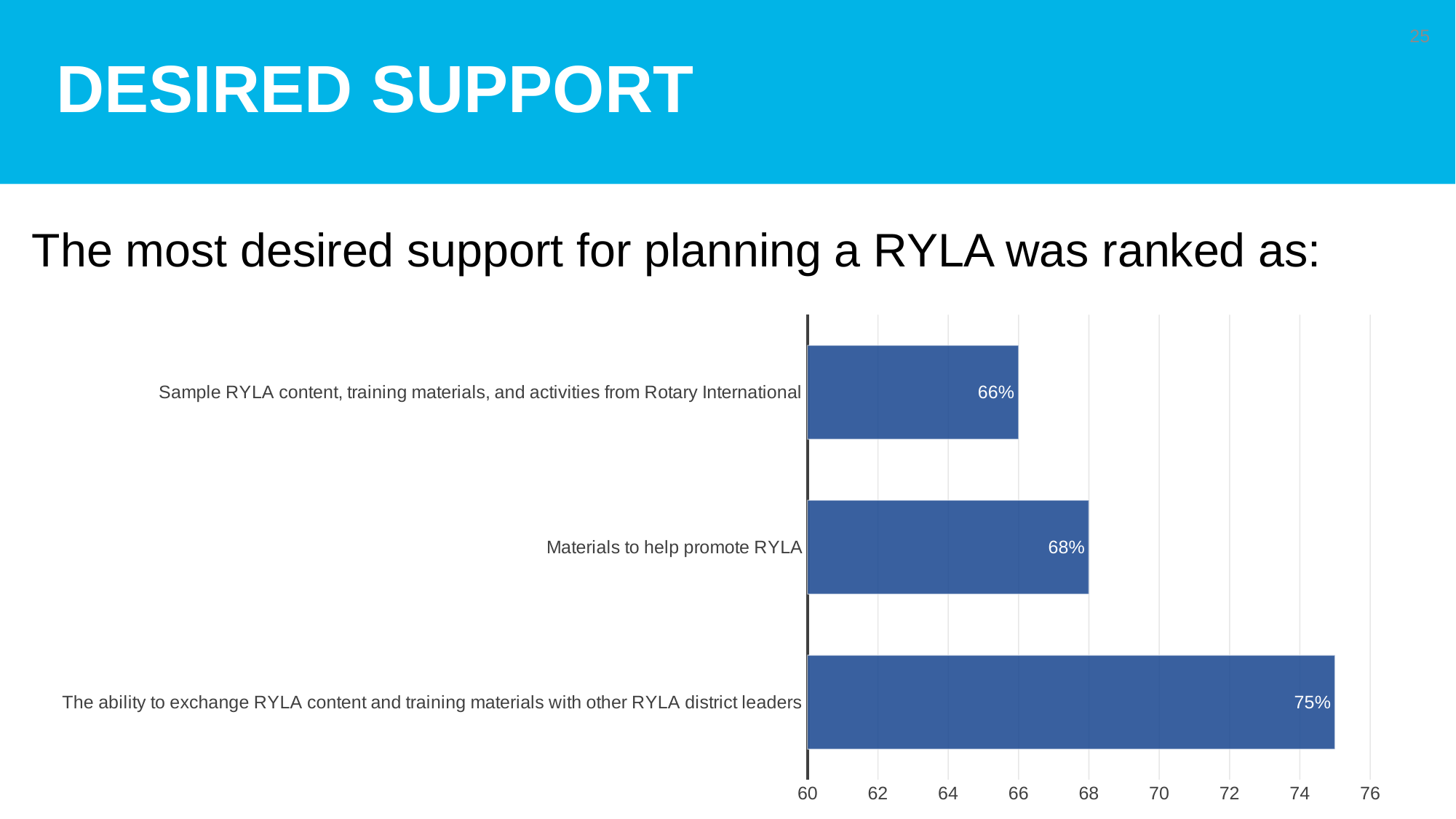
Is the value for 'Materials to help promote RYLA' greater or less than 70? less What kind of chart is shown on the slide? Bar chart How many categories of desired support are shown in the chart? 3 What is the difference between the percentage for exchanging RYLA content with other district leaders and the percentage for materials to help promote RYLA? 7% What percentage is shown for the ability to exchange RYLA content and training materials with other RYLA district leaders? 75% What is the maximum value shown on the horizontal axis of the chart? 76 What is the value for 'Materials to help promote RYLA'? 68% Which type of support has the lowest percentage? Sample RYLA content, training materials, and activities from Rotary International Which is larger: the value for 'Materials to help promote RYLA' or the value for sample RYLA content from Rotary International? Materials to help promote RYLA What percentage of respondents desired sample RYLA content, training materials, and activities from Rotary International? 66% What is the difference between the value for 'Materials to help promote RYLA' and the value for sample RYLA content from Rotary International? 2% Which type of support has the highest percentage? The ability to exchange RYLA content and training materials with other RYLA district leaders